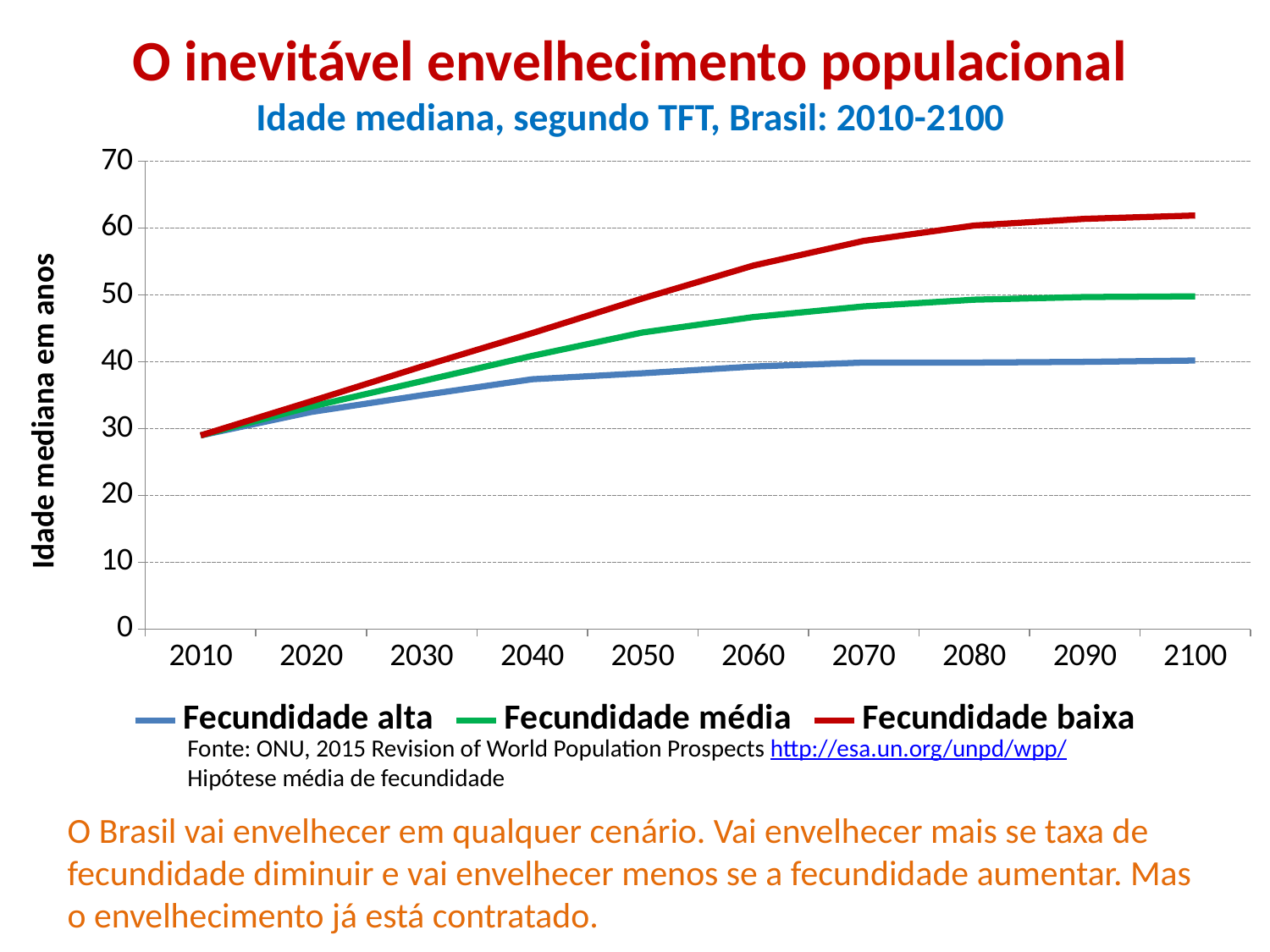
Which series has the lowest value in 2100? Fecundidade alta Which series has the highest value in 2100? Fecundidade baixa Is the value for Fecundidade média in 2050 greater or less than 40? greater How many series does the legend list? 3 Is the value for Fecundidade alta in 2100 greater or less than 50? less How many years are labeled on the x axis? 10 Is the value for Fecundidade baixa in 2060 greater or less than 50? greater What kind of chart is shown on the slide? line chart Does the Fecundidade baixa line rise or fall from 2010 to 2100? rise In 2080, which is larger: Fecundidade média or Fecundidade alta? Fecundidade média What colour is the Fecundidade alta line? blue